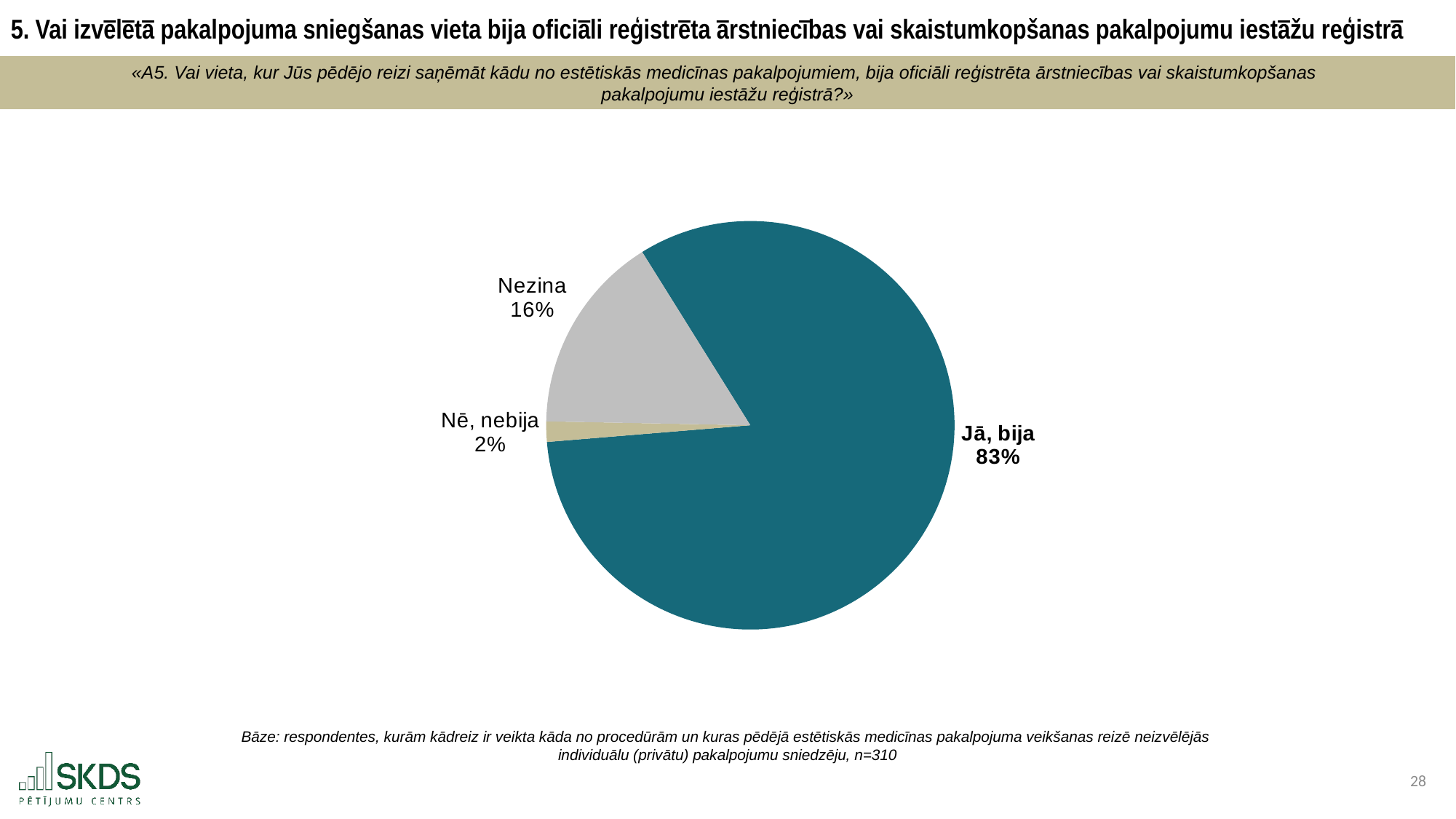
Which answer has the largest slice of the pie? Jā, bija What is the difference in percentage points between "Jā, bija" and "Nezina"? 67 What kind of chart is shown on the slide? pie chart Which is larger, the share for "Nezina" or the share for "Nē, nebija"? Nezina What is the difference in percentage points between "Nezina" and "Nē, nebija"? 14 What share of respondents answered "Nezina"? 16% What colour is the "Jā, bija" slice? teal Which answer has the smallest slice of the pie? Nē, nebija What share of respondents answered "Jā, bija"? 83% How many slices does the pie chart have? 3 What share of respondents answered "Nē, nebija"? 2% What is the sample size (n) stated in the base note below the chart? n=310